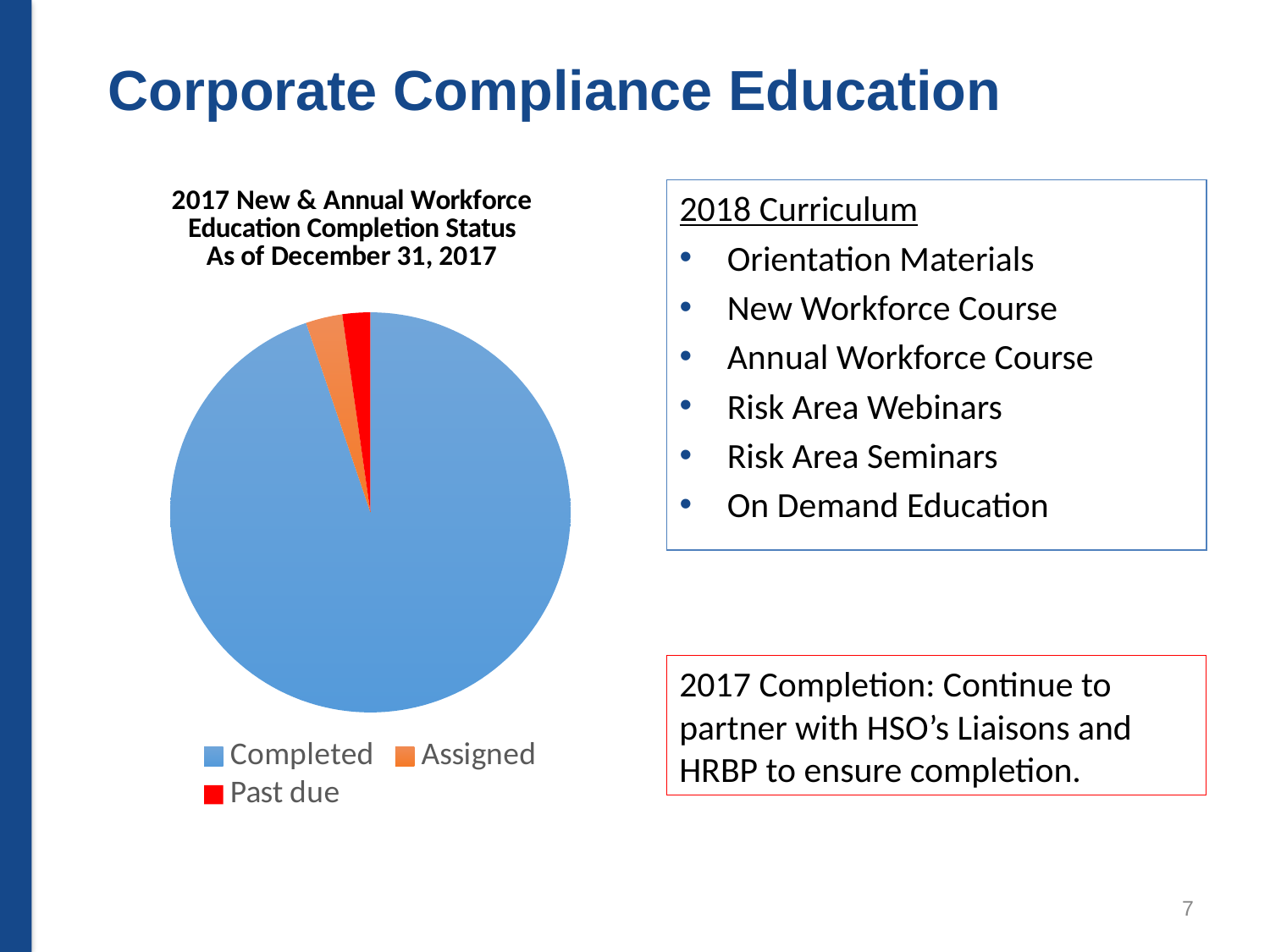
How many categories does the pie chart show? 3 Which category has the smallest slice of the pie chart? Past due Which category has the largest slice of the pie chart? Completed Which is larger in the pie chart, Completed or Past due? Completed How many entries does the pie chart's legend list? 3 What colour represents the Completed category in the pie chart? blue What kind of chart is shown on the slide? pie chart What is the title of the pie chart? 2017 New & Annual Workforce Education Completion Status As of December 31, 2017 Which is larger in the pie chart, Completed or Assigned? Completed